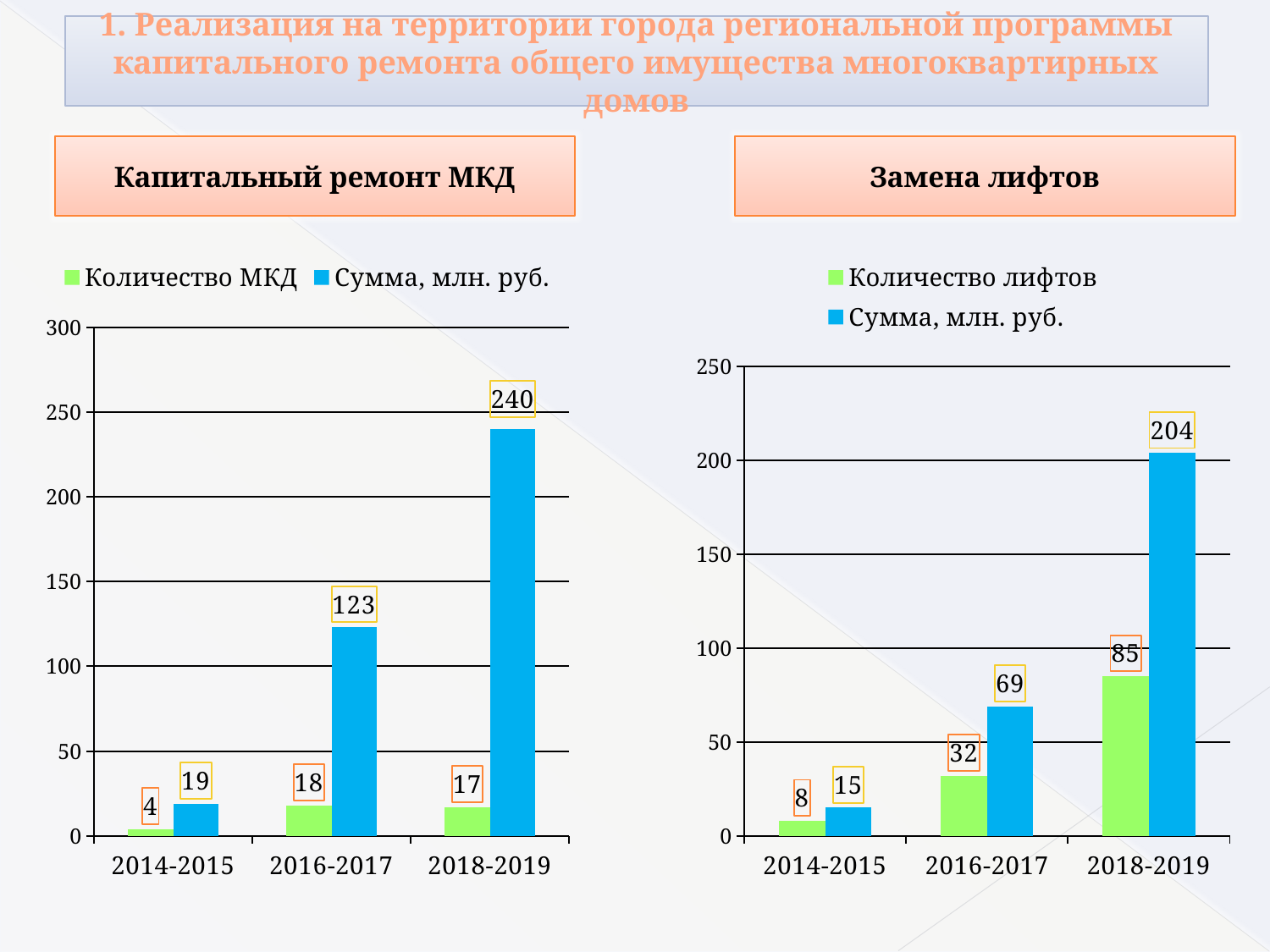
In the 'Замена лифтов' chart, what is the value of 'Сумма, млн. руб.' for 2016-2017? 69 In the 'Замена лифтов' chart, does 'Сумма, млн. руб.' rise or fall from 2014-2015 to 2018-2019? rise In the 'Капитальный ремонт МКД' chart, which period has the highest 'Сумма, млн. руб.'? 2018-2019 In the 'Капитальный ремонт МКД' chart, which is larger: 'Количество МКД' for 2016-2017 or for 2018-2019? 2016-2017 How many periods are shown on the x axis of the 'Замена лифтов' chart? 3 In the 'Капитальный ремонт МКД' chart, what is the difference in 'Сумма, млн. руб.' between 2018-2019 and 2016-2017? 117 In the 'Капитальный ремонт МКД' chart, what is the value of 'Сумма, млн. руб.' for 2018-2019? 240 In the 'Капитальный ремонт МКД' chart, what is the value of 'Количество МКД' for 2014-2015? 4 How many series does the legend of the 'Капитальный ремонт МКД' chart list? 2 In the 'Замена лифтов' chart, what is the difference in 'Количество лифтов' between 2018-2019 and 2016-2017? 53 In the 'Замена лифтов' chart, what is the value of 'Количество лифтов' for 2018-2019? 85 In the 'Замена лифтов' chart, which period has the lowest 'Количество лифтов'? 2014-2015